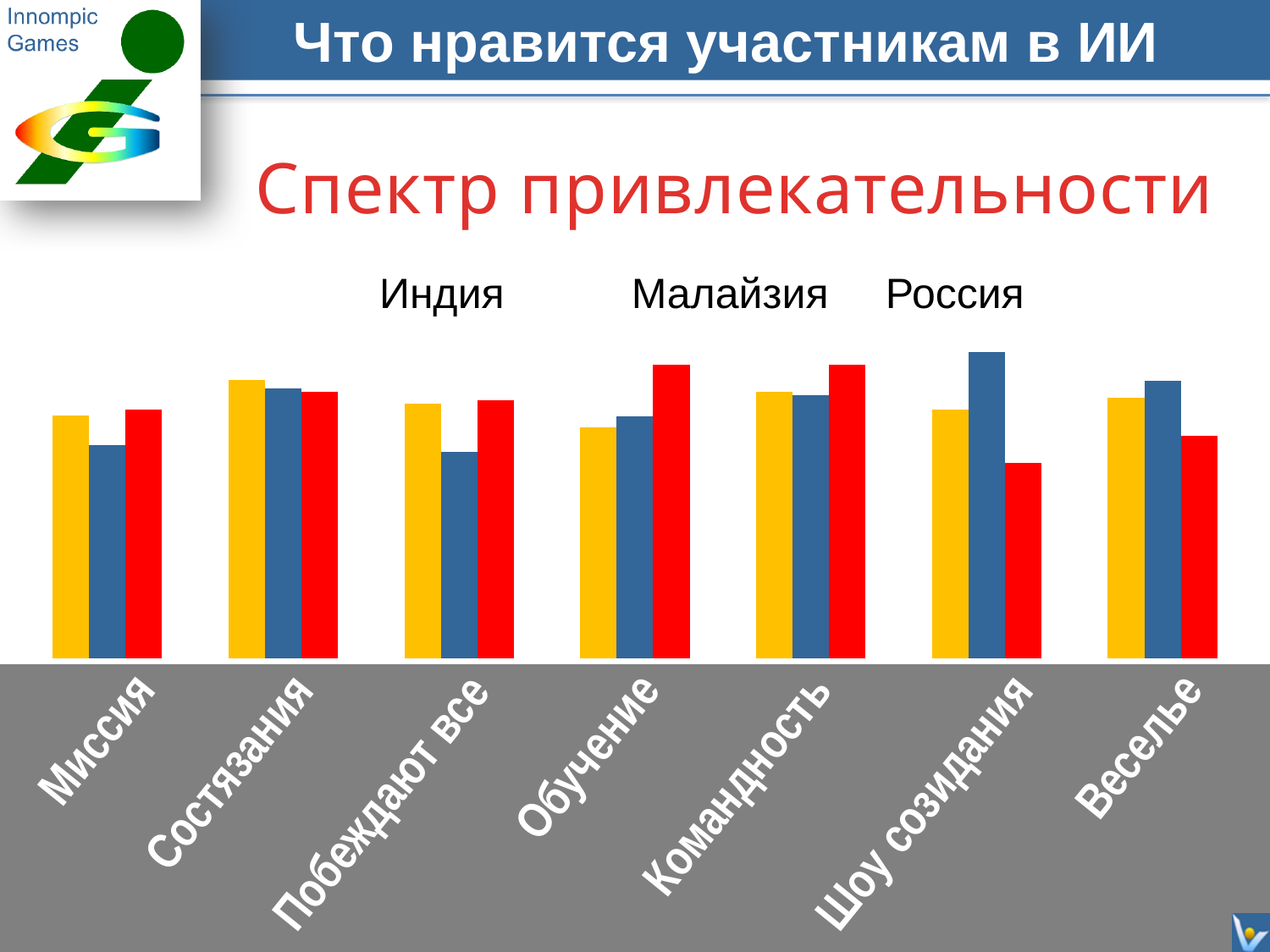
In the Веселье category, which coloured bar is the shortest? the red bar How many series does the legend list? 3 Across all categories, in which category is the red bar the shortest? Шоу созидания Which series names are listed in the legend above the chart? Индия, Малайзия, Россия What kind of chart is shown on the slide? bar chart In the Побеждают все category, which coloured bar is the shortest? the blue bar In the Шоу созидания category, which coloured bar is the tallest? the blue bar How many categories are shown along the bottom of the chart? 7 What is the red title text above the chart? Спектр привлекательности Across all categories, in which category is the blue bar the tallest? Шоу созидания